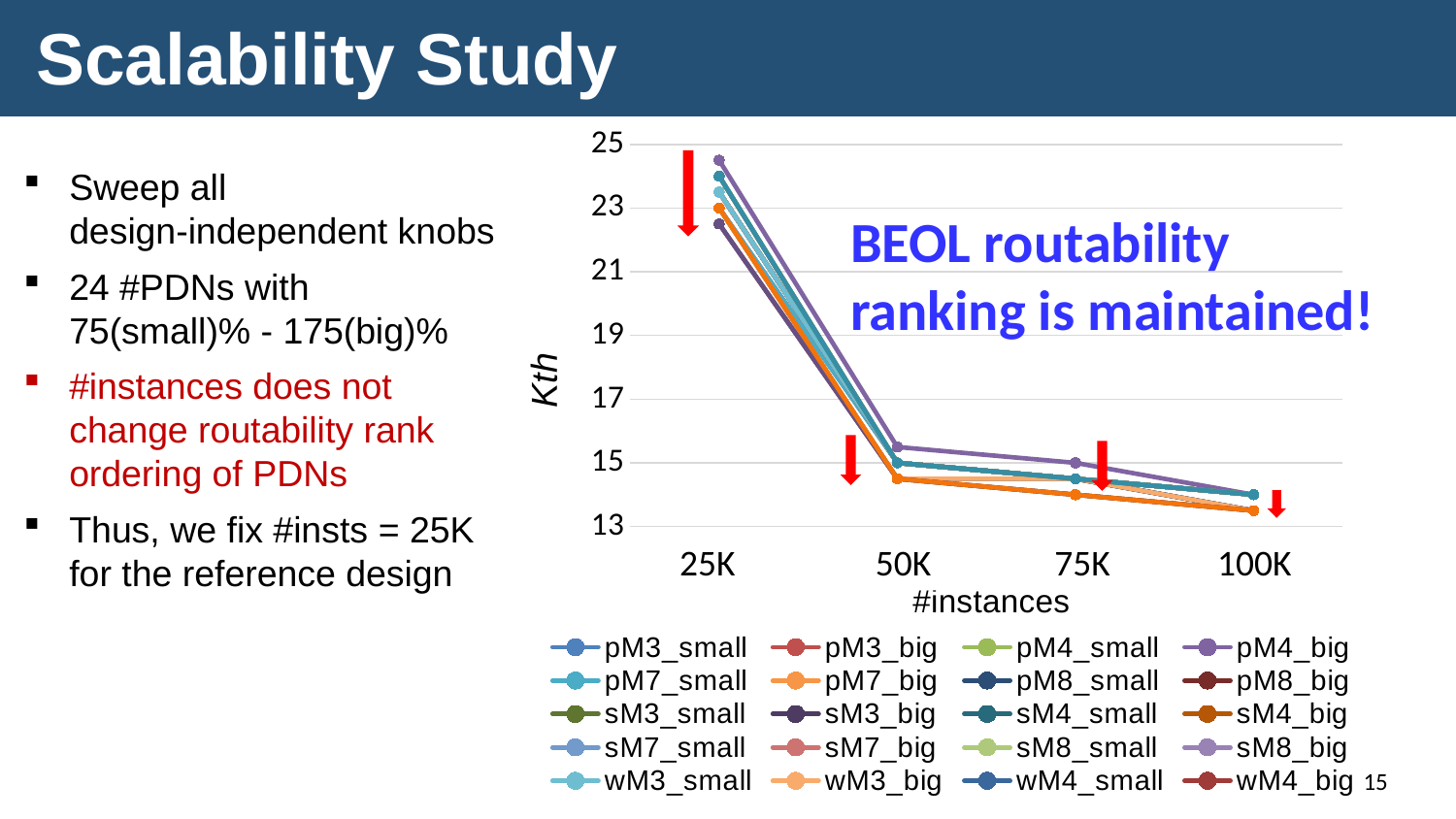
What kind of chart is shown on the slide? line chart How many series does the legend list? 20 Are the Kth values larger at 25K instances or at 100K instances? 25K What is the label of the y axis? Kth At 25K instances, are the Kth values for all series greater or less than 21? greater Is the spread between the series wider at 25K instances or at 100K instances? 25K At 100K instances, are the Kth values for all series greater or less than 15? less What is the label of the x axis? #instances Do the Kth values rise or fall as #instances increases from 25K to 100K? fall At 50K instances, are the Kth values for all series greater or less than 17? less How many #instances values are plotted along the x axis? 4